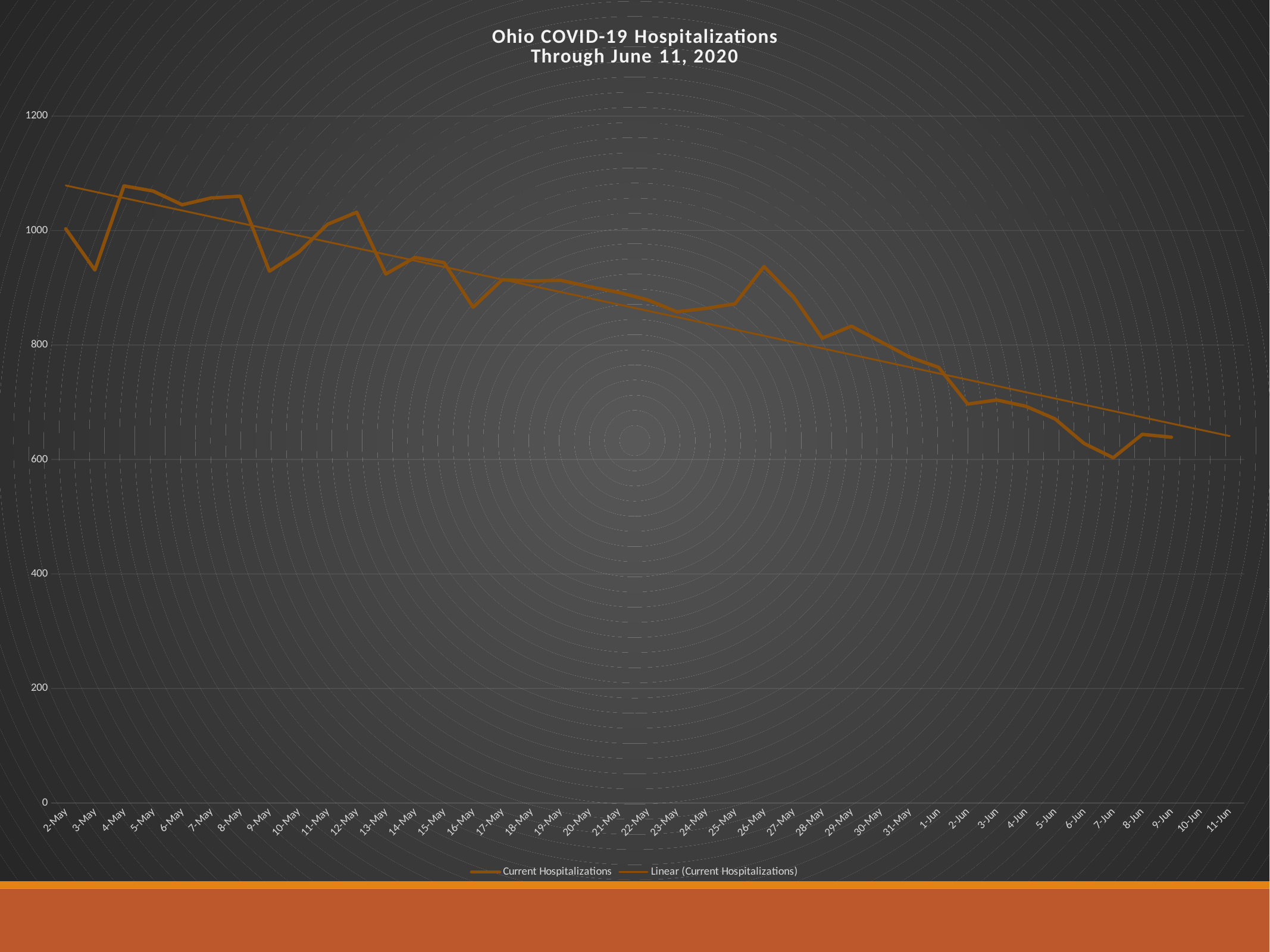
Is the value for Current Hospitalizations on 26-May greater or less than 800? greater How many dates are labelled along the x axis? 41 What is the title of the chart? Ohio COVID-19 Hospitalizations Through June 11, 2020 Do current hospitalizations generally rise or fall from 2-May to 9-Jun? fall Is the value for Current Hospitalizations on 6-Jun greater or less than 800? less What are the two legend entries? Current Hospitalizations; Linear (Current Hospitalizations) What kind of chart is shown on the slide? line chart Is the value for Current Hospitalizations on 16-May greater or less than 1000? less On which date are current hospitalizations lowest? 7-Jun How many entries does the legend list? 2 Which date has more current hospitalizations, 4-May or 9-May? 4-May